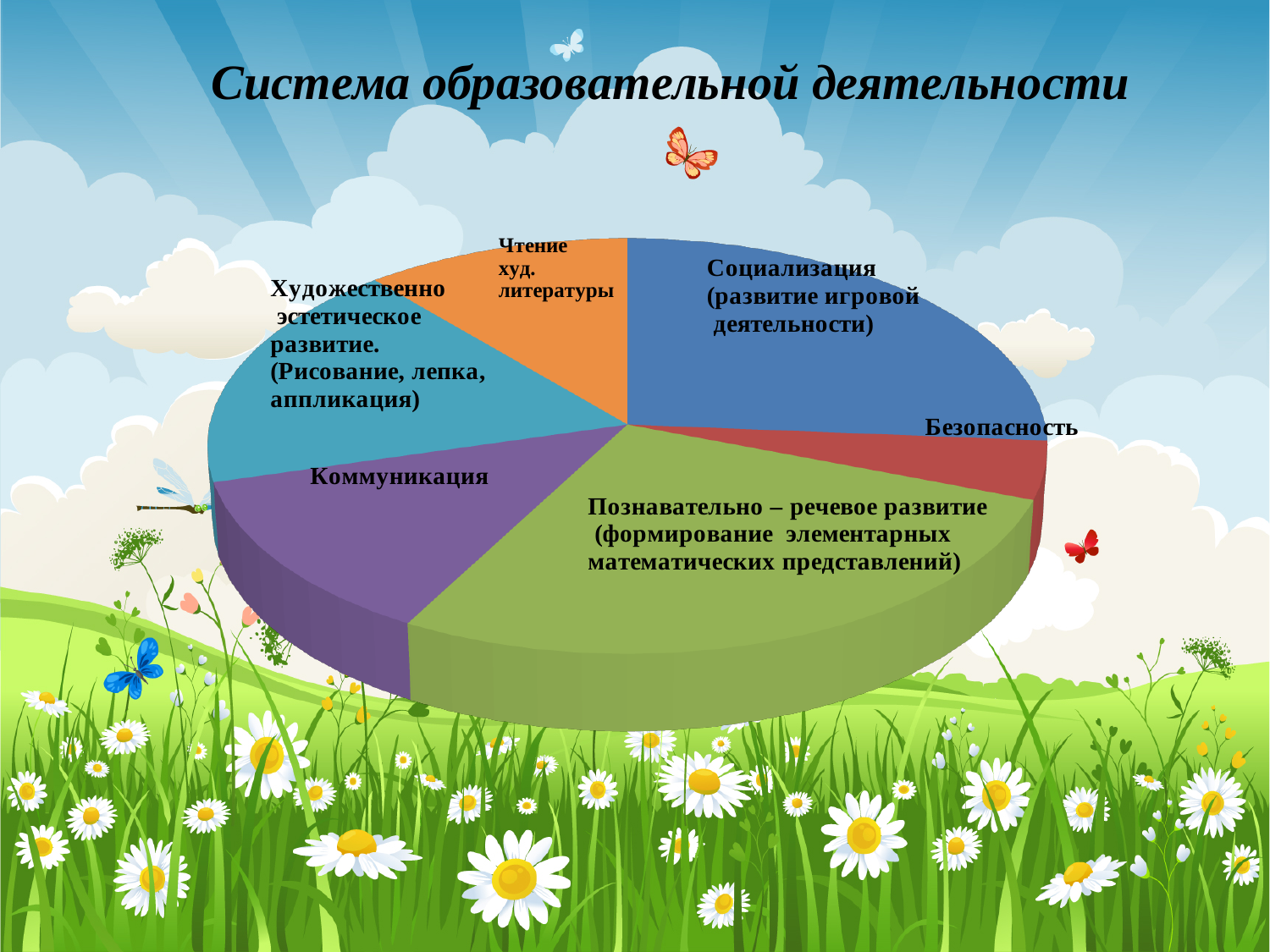
Which category has the largest slice of the pie chart? Познавательно – речевое развитие (формирование элементарных математических представлений) How many slices does the pie chart have? 6 Which category has the smallest slice of the pie chart? Безопасность What kind of chart is shown on the slide? Pie chart Which slice is larger: Коммуникация or Чтение худ. литературы? Коммуникация Which slice is larger: Познавательно – речевое развитие or Социализация? Познавательно – речевое развитие Which slice is larger: Социализация or Безопасность? Социализация What colour is the Безопасность slice of the pie chart? Red What is the title of the slide containing the pie chart? Система образовательной деятельности